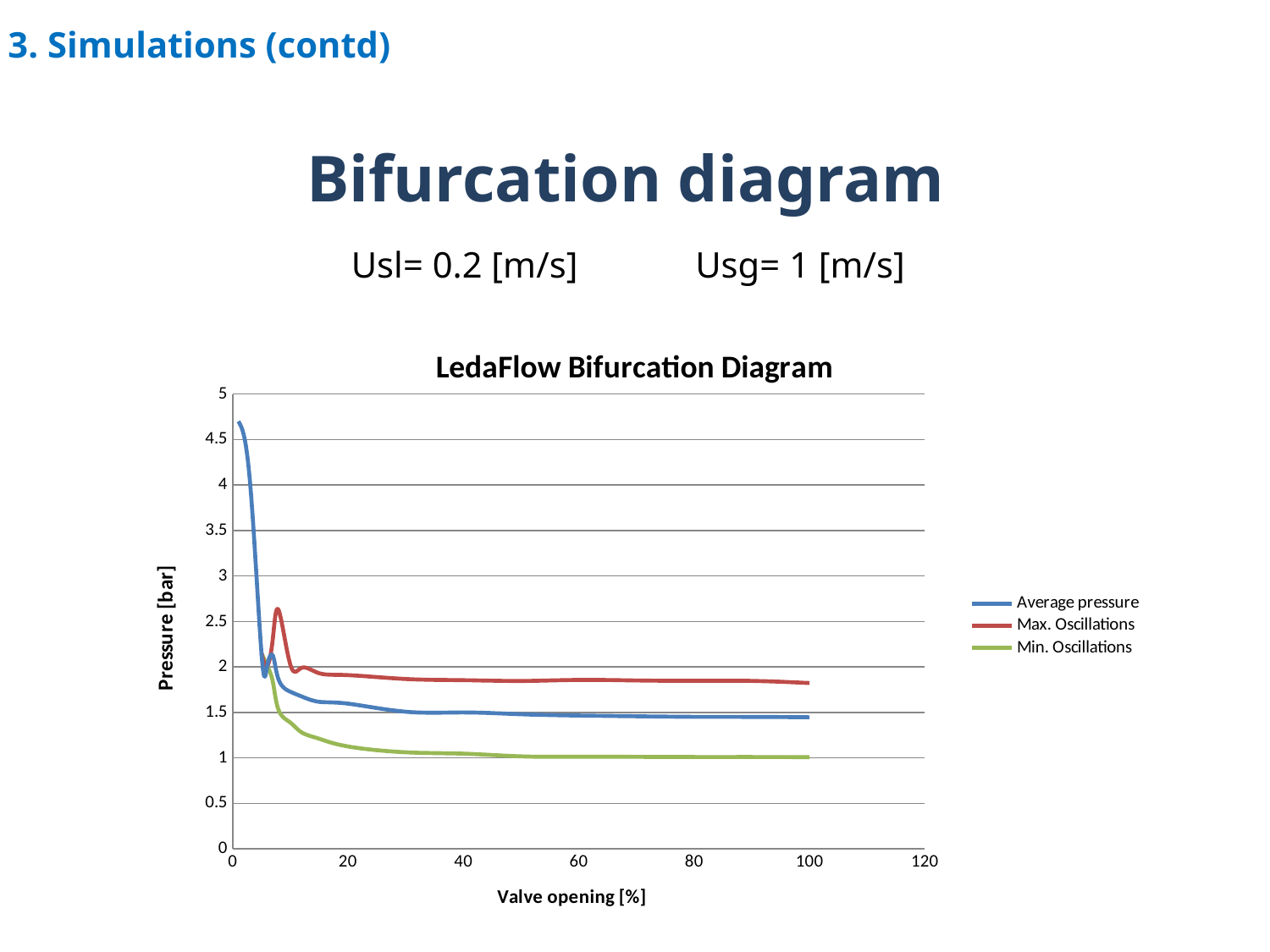
What is the title of the chart? LedaFlow Bifurcation Diagram What is the label of the vertical axis of the chart? Pressure [bar] Is the leftmost value of the Average pressure series greater or less than 4? greater What kind of chart is the LedaFlow Bifurcation Diagram? line chart Is the value of Max. Oscillations at a valve opening of 100 greater or less than 2? less Is the value of Min. Oscillations at a valve opening of 100 greater or less than 1.5? less Does the Average pressure series rise or fall as valve opening increases? fall At a valve opening of 60, which series is higher: Max. Oscillations or Min. Oscillations? Max. Oscillations How many series does the legend of the chart list? 3 Which series has the highest value at a valve opening of 40? Max. Oscillations Which series has the lowest value at a valve opening of 80? Min. Oscillations